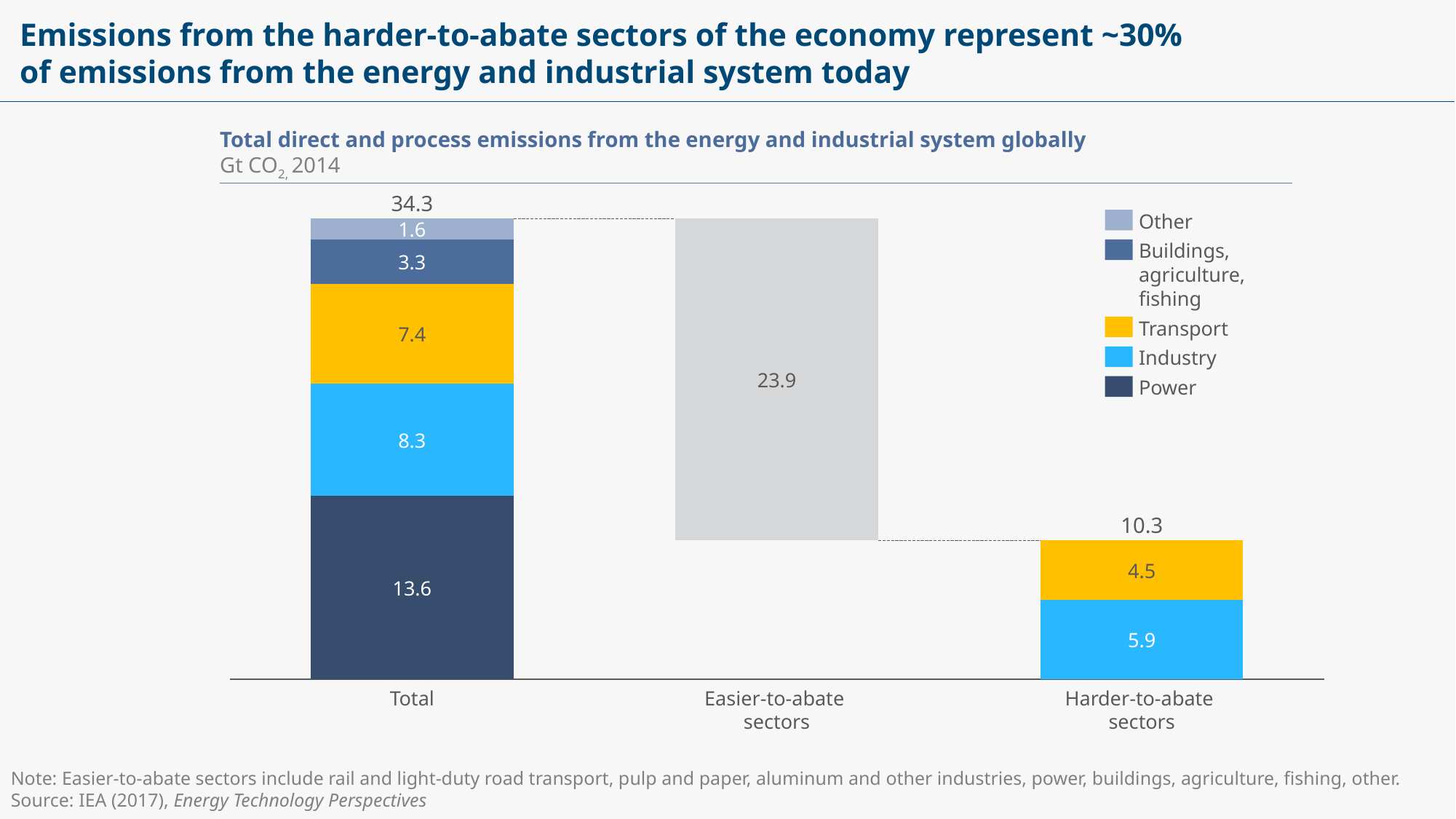
What is the difference between the Industry value in the Total bar and the Industry value in the Harder-to-abate sectors bar? 2.4 What is the total of the Harder-to-abate sectors bar? 10.3 How many series does the legend list? 5 What is the total of the Total bar? 34.3 What is the Transport value in the Harder-to-abate sectors bar? 4.5 Which segment is the smallest in the Total bar? Other What is the value shown for Easier-to-abate sectors? 23.9 Which is larger in the Harder-to-abate sectors bar, Industry or Transport? Industry What is the Power value in the Total bar? 13.6 Which segment is the largest in the Total bar? Power What kind of chart is shown on the slide? Stacked bar chart How many categories are shown on the x axis? 3